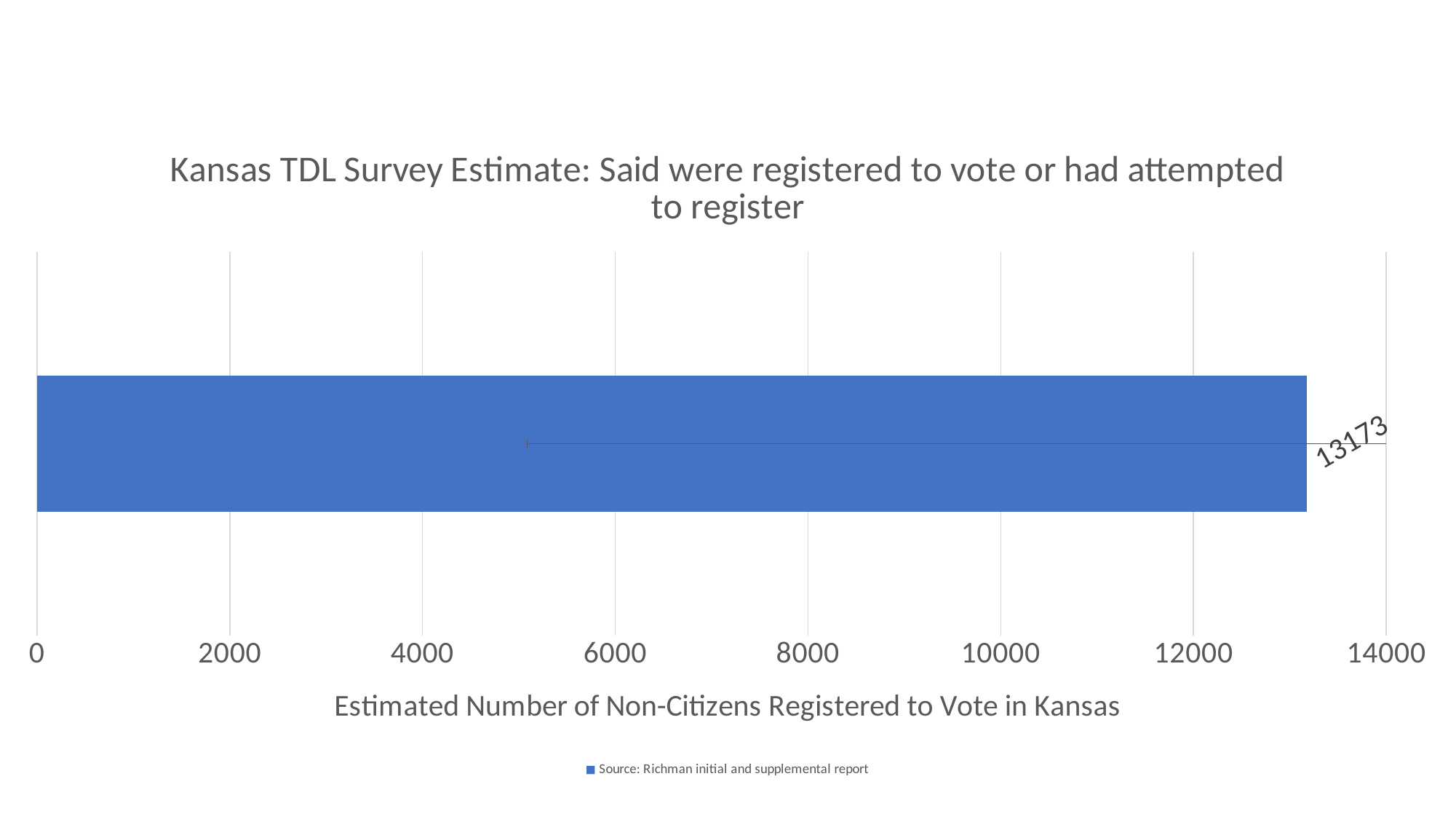
How many series does the legend list? 1 What is the title of the chart? Kansas TDL Survey Estimate: Said were registered to vote or had attempted to register What is the maximum value shown on the horizontal axis? 14000 What kind of chart is shown on the slide? bar chart What is the legend entry for the series? Source: Richman initial and supplemental report Is the value of the bar greater or less than 12000? greater How many bars are plotted in the chart? 1 What value is shown by the data label on the bar? 13173 Is the value of the bar greater or less than 14000? less